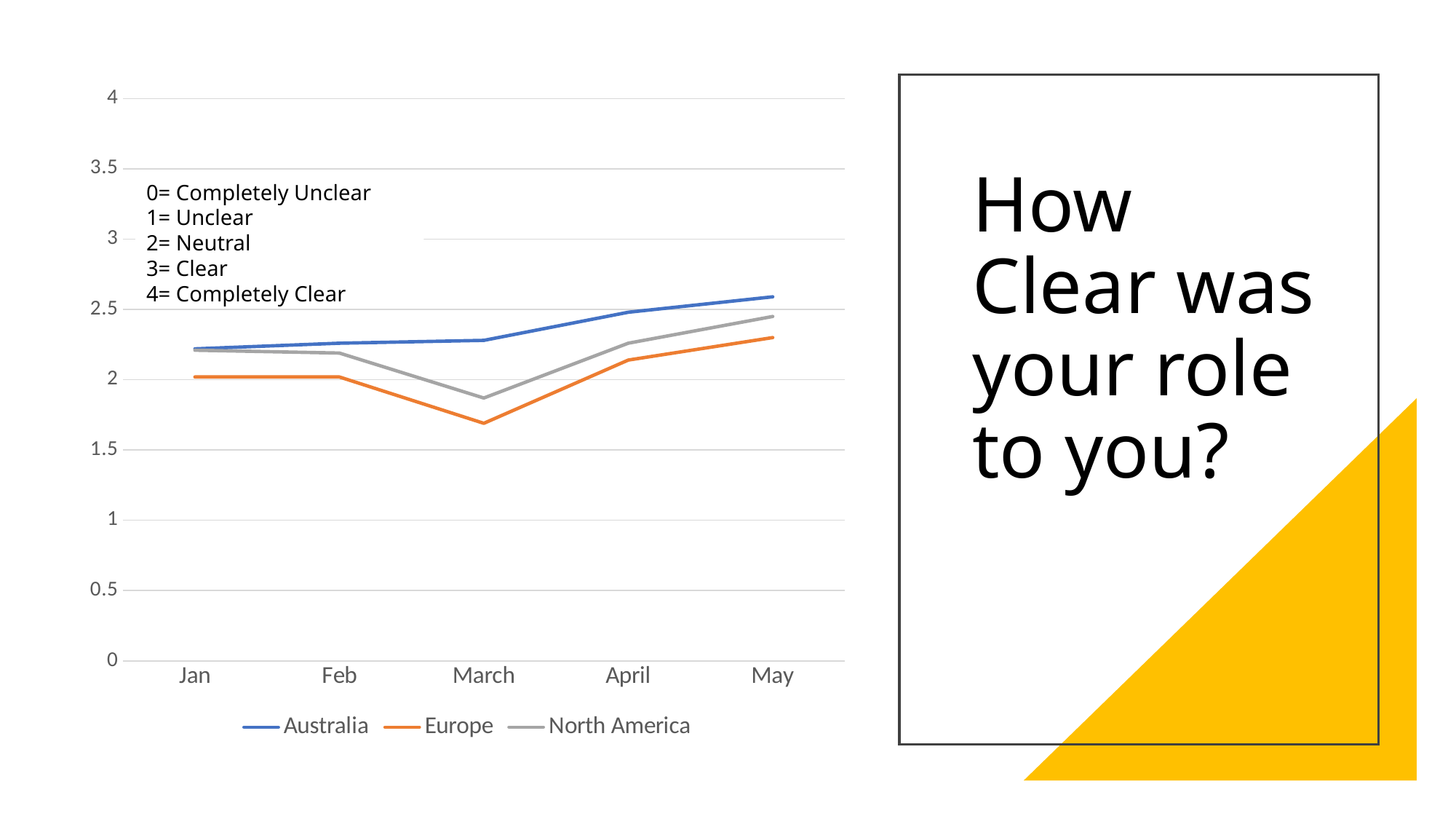
Is the value for Australia in May greater or less than 2.5? greater What kind of chart is shown on the slide? line chart In which month is the Europe line at its lowest? March How many series does the legend list? 3 How many months are shown on the x axis? 5 In which month is the Australia line at its highest? May Which series has the lowest value in March? Europe Is the value for Europe in March greater or less than 2? less Is the value for North America in March greater or less than 2? less In March, which is larger: the value for Australia or the value for Europe? Australia Does the Australia line rise or fall from Jan to May? rise